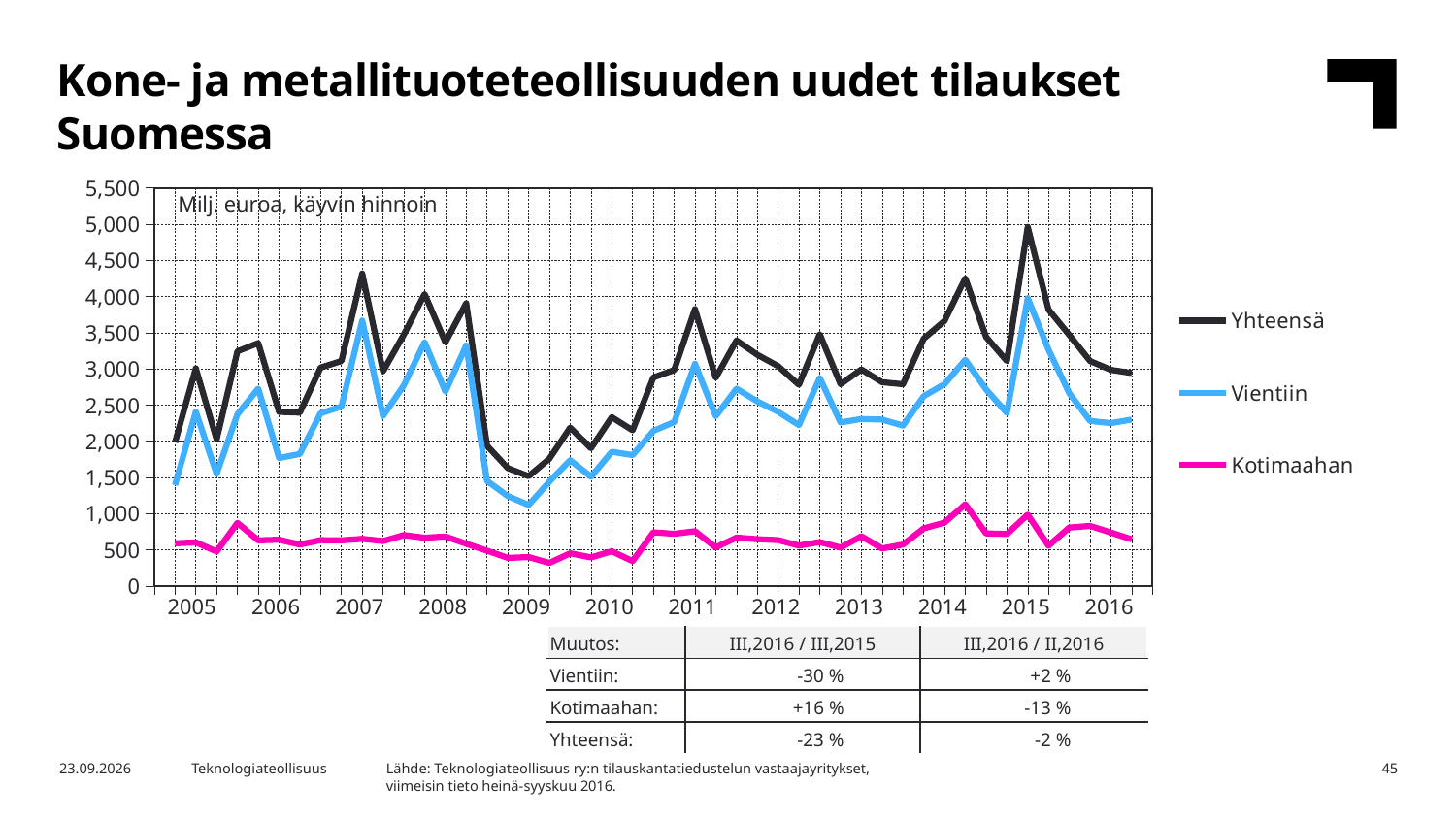
Is the lowest value of Vientiin in 2009 greater or less than 1,500? less Does the Yhteensä series rise or fall from its 2015 peak to the end of 2016? fall How many years are labelled on the x axis? 12 What kind of chart is shown on the slide? line chart Which series has the lowest values throughout the chart? Kotimaahan What unit is stated in the text box inside the chart? Milj. euroa, käyvin hinnoin Which series has the highest values throughout the chart? Yhteensä Is the value for Kotimaahan in 2009 greater or less than 1,000? less Which is larger in 2014, Vientiin or Kotimaahan? Vientiin Is the peak value of Yhteensä in 2015 greater or less than 4,500? greater What are the three series named in the legend? Yhteensä, Vientiin, Kotimaahan How many series does the legend list? 3